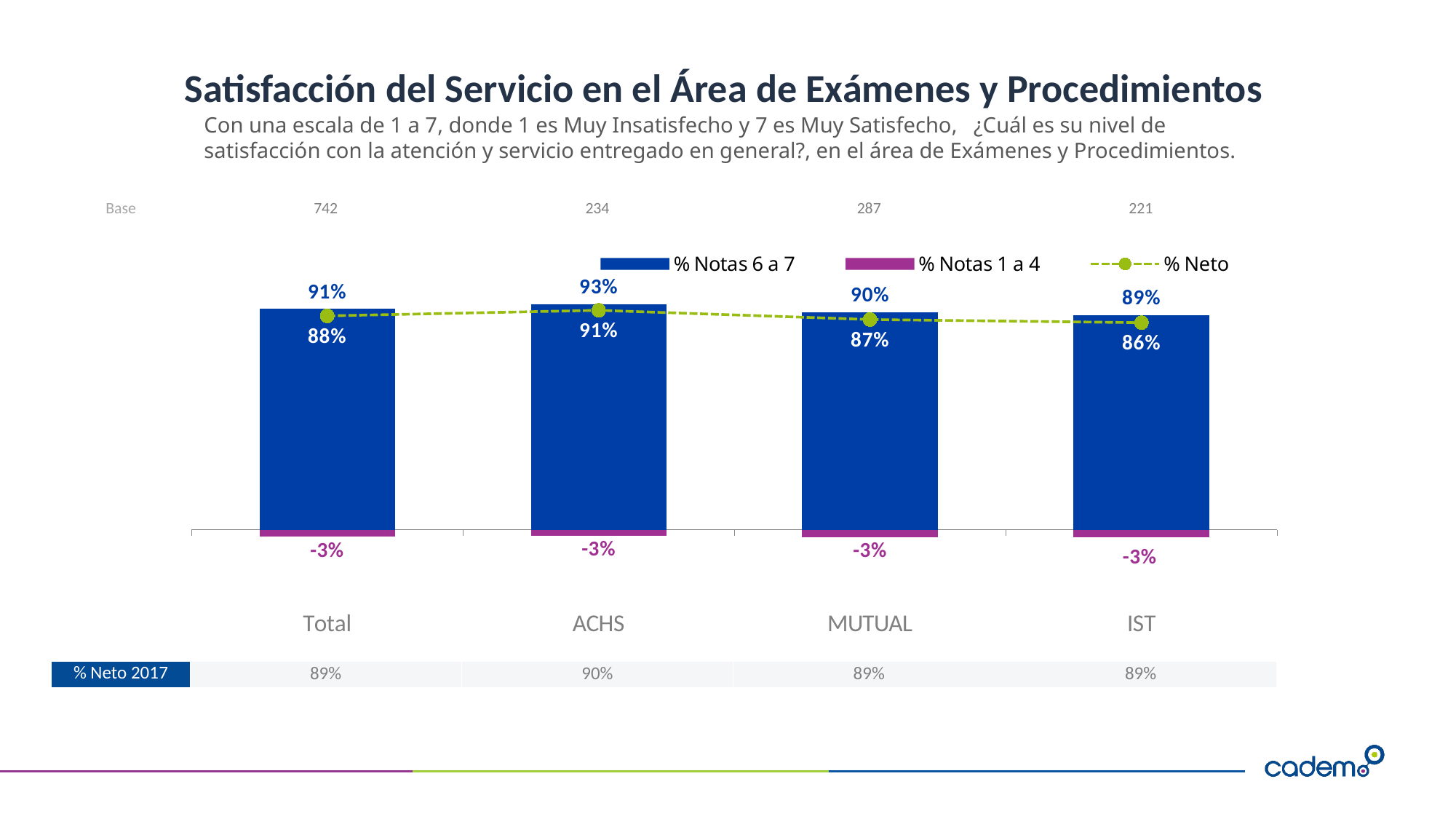
Which is larger, the % Neto value for Total or for MUTUAL? Total What is the % Neto 2017 value shown for ACHS in the table below the chart? 90% What kind of chart is shown on the slide? Bar chart with a line How many series does the legend list? 3 What is the % Notas 1 a 4 value for IST? -3% What is the % Neto value for Total? 88% What is the difference between the % Notas 6 a 7 values for ACHS and IST? 4% Which category has the highest % Notas 6 a 7 value? ACHS What is the % Notas 6 a 7 value for ACHS? 93% Which category has the lowest % Neto value? IST How many categories are shown on the x axis? 4 What is the % Neto value for MUTUAL? 87%